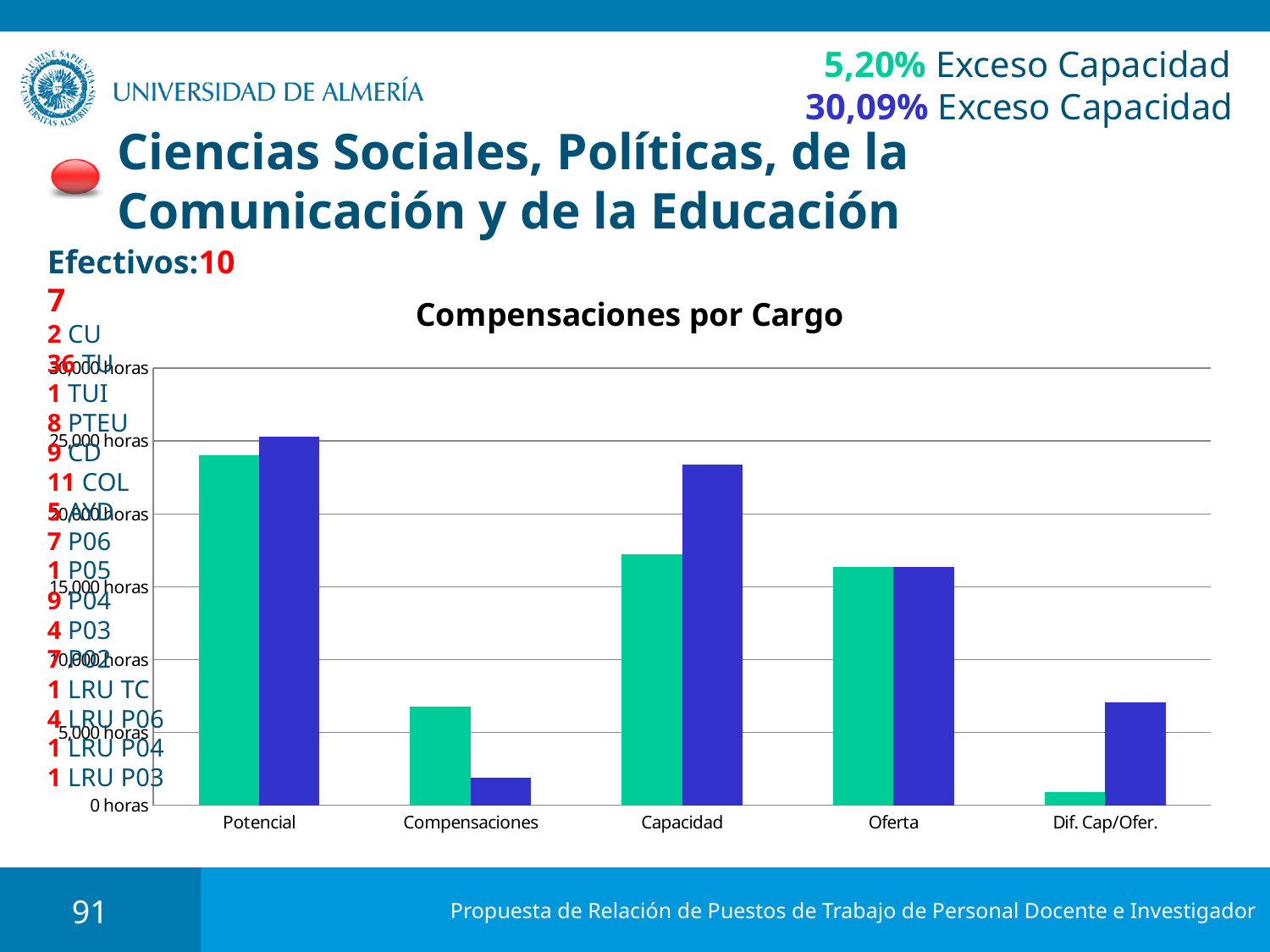
Which category has the tallest green bar? Potencial Which category has the tallest blue bar? Potencial Is the green bar for Potencial greater or less than 20,000 horas? greater For Compensaciones, which bar is taller, the green one or the blue one? the green one Is the blue bar for Capacidad greater or less than 20,000 horas? greater Which category has the shortest green bar? Dif. Cap/Ofer. How many categories are shown on the x axis of the chart? 5 What is the title of the chart? Compensaciones por Cargo For Capacidad, which bar is taller, the green one or the blue one? the blue one What kind of chart is shown on the slide? bar chart Which category has the shortest blue bar? Compensaciones Is the blue bar for Compensaciones greater or less than 5,000 horas? less